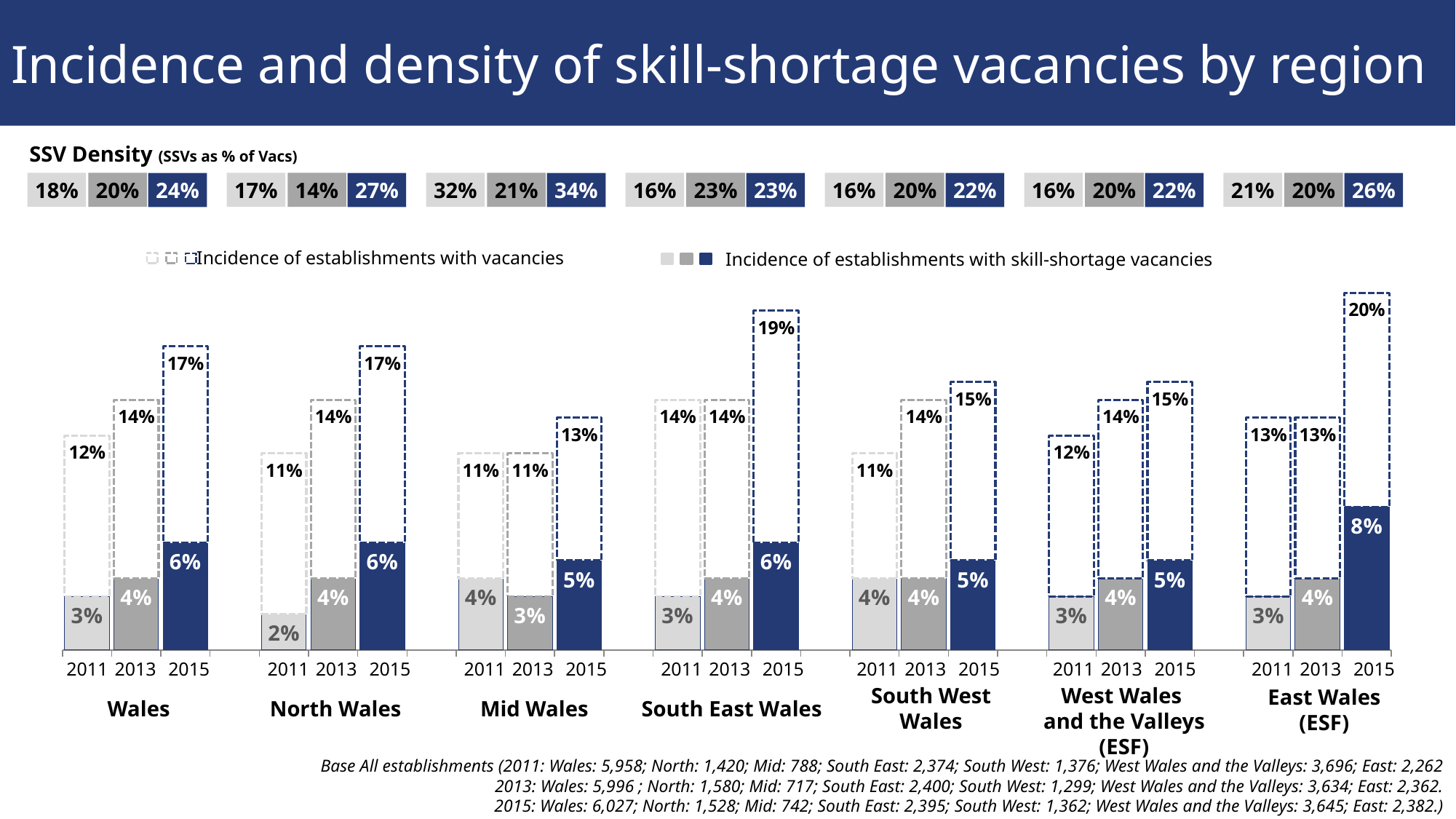
What is the SSV density for Mid Wales in 2015? 34% What kind of chart is shown on the slide? Bar chart Which region has the lowest incidence of establishments with skill-shortage vacancies in 2011? North Wales Which is larger: the incidence of establishments with skill-shortage vacancies in East Wales (ESF) in 2015 or in Wales in 2015? East Wales (ESF) in 2015 How many regions are shown on the chart? 7 How does the incidence of establishments with skill-shortage vacancies in Wales change from 2011 to 2015? It rises What is the difference between the incidence of establishments with vacancies in Wales in 2015 and in 2011? 5 percentage points Which region has the highest incidence of establishments with vacancies in 2015? East Wales (ESF) What is the incidence of establishments with vacancies in South East Wales in 2015? 19% What is the incidence of establishments with skill-shortage vacancies in East Wales (ESF) in 2015? 8% What is the incidence of establishments with skill-shortage vacancies in North Wales in 2011? 2% Which years are shown for each region on the chart? 2011, 2013 and 2015